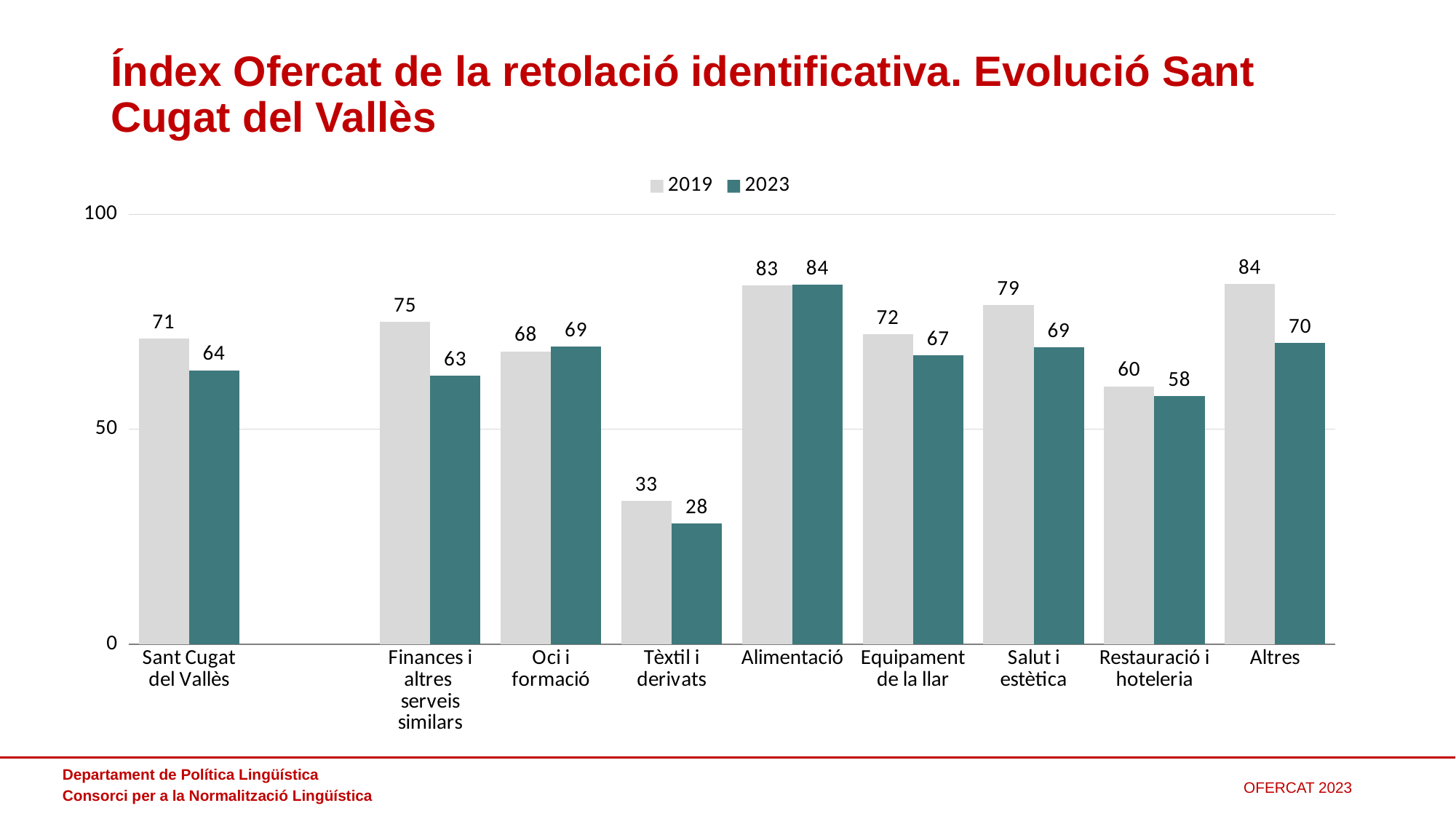
How many series does the legend list? 2 Which category has the lowest 2019 value? Tèxtil i derivats What is the 2023 value for Equipament de la llar? 67 How many categories are shown on the x axis? 9 Which series is shown in dark teal? 2023 What is the 2023 value for Tèxtil i derivats? 28 Which is larger for Oci i formació, the 2019 value or the 2023 value? 2023 Is the 2019 value for Salut i estètica greater or less than 50? greater What is the 2019 value for Sant Cugat del Vallès? 71 What is the difference between the 2019 and 2023 values for Altres? 14 What kind of chart is shown on the slide? bar chart Which category has the highest 2023 value? Alimentació